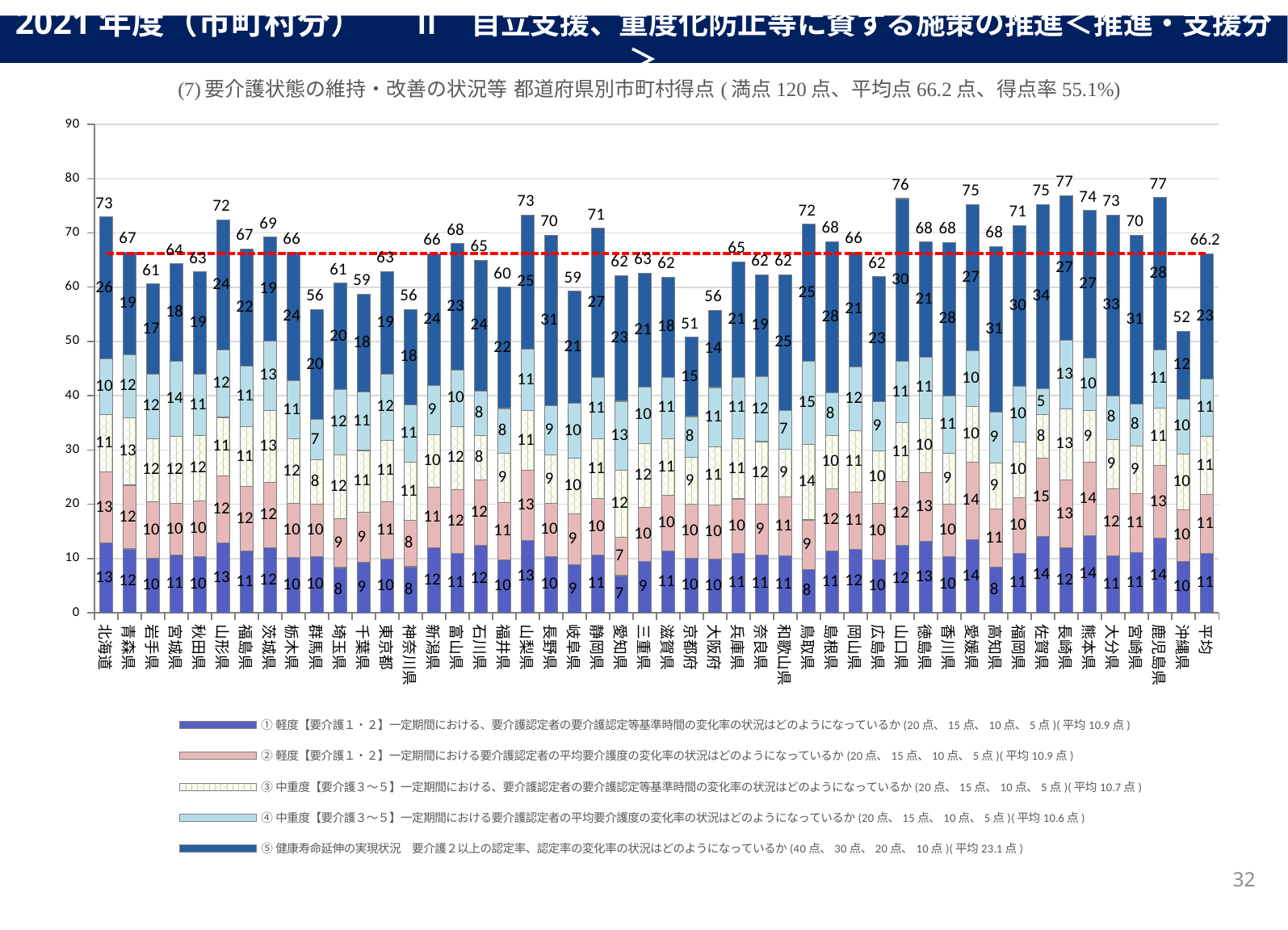
What is the total score shown for 京都府? 51 What is the total score shown for 沖縄県? 52 Is the total score for 群馬県 greater or less than 60? less Which has a higher total score, 山口県 or 愛媛県? 山口県 What is the difference between the total score of 長崎県 and that of 京都府? 26 What is the total score shown for 北海道? 73 What is the value of the top (dark blue, ⑤) segment for 北海道? 26 How many series does the legend list? 5 What is the value shown for 平均 (the last bar)? 66.2 What is the full score (満点) stated in the chart title? 120 点 What kind of chart is shown on the slide? Stacked bar chart Which prefecture has the lowest total score? 京都府